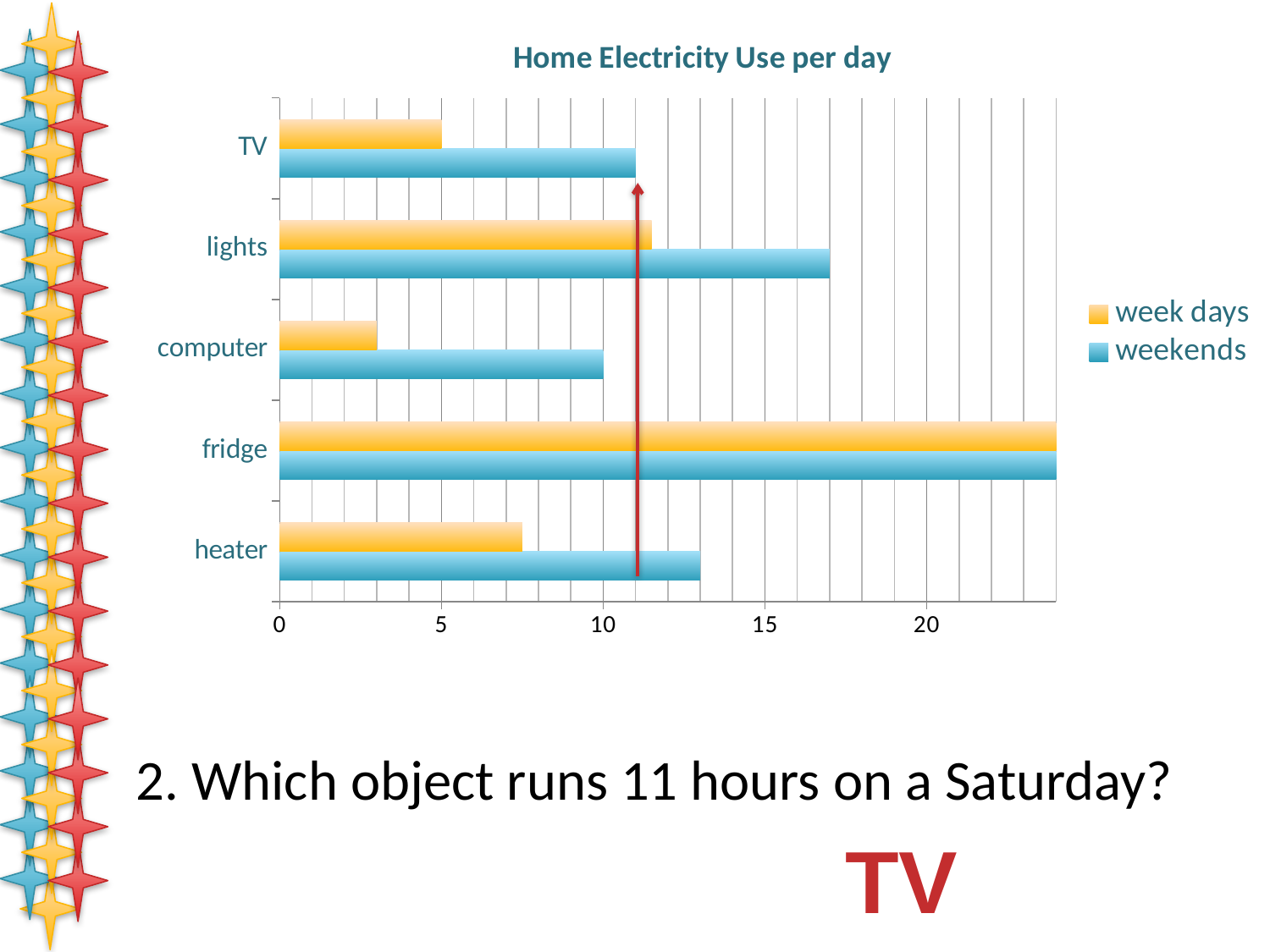
Is the week days value for fridge greater or less than 20? greater How many hours per day is the TV used on weekends? 11 Which object has the lowest week days electricity use? computer How many series does the legend list in the Home Electricity Use per day chart? 2 What is the title of the chart? Home Electricity Use per day How many objects (categories) are shown in the Home Electricity Use per day chart? 5 On weekends, which is used for more hours: lights or heater? lights What kind of chart is shown on the slide? bar chart How many hours per day is the computer used on weekends? 10 Which object has the highest weekend electricity use? fridge Is the weekends value for heater greater or less than 15? less How many hours per day is the TV used on week days? 5